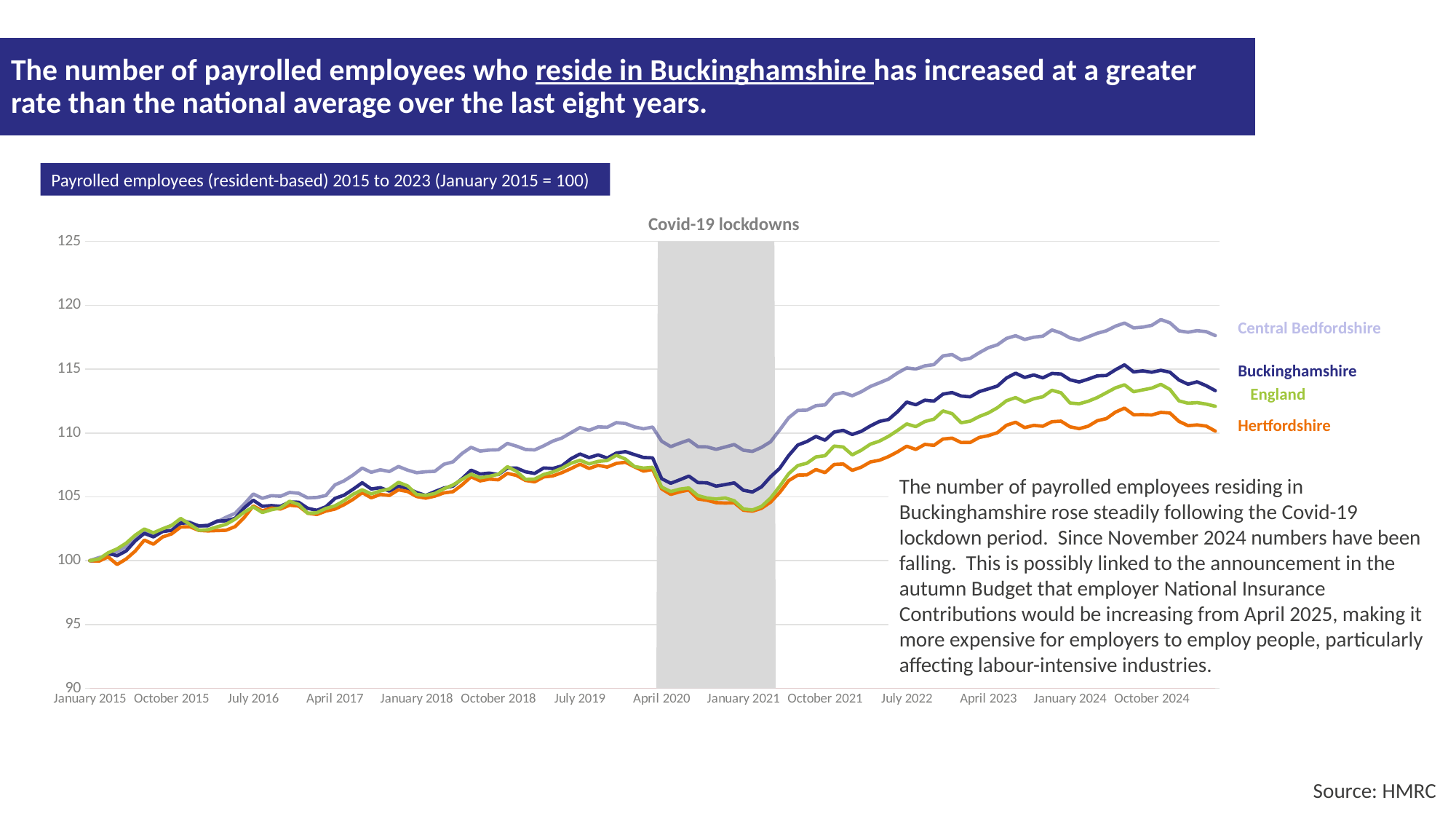
Overall, do the values rise or fall from January 2015 to October 2024? rise Is the value for Buckinghamshire at the end of the period greater or less than 110? greater Which series has the lowest value at the end of the period (late 2024)? Hertfordshire At the end of the period, which is higher: Buckinghamshire or England? Buckinghamshire What kind of chart is shown on the slide? line chart What is the index value for all series in January 2015? 100 Which series has the highest value at the end of the period (late 2024)? Central Bedfordshire How many series (areas) are plotted on the chart? 4 Is the peak value for Central Bedfordshire greater or less than 120? less What does the grey shaded area on the chart represent? Covid-19 lockdowns What is the source of the chart data? HMRC Is the value for Central Bedfordshire at the end of the period greater or less than 115? greater